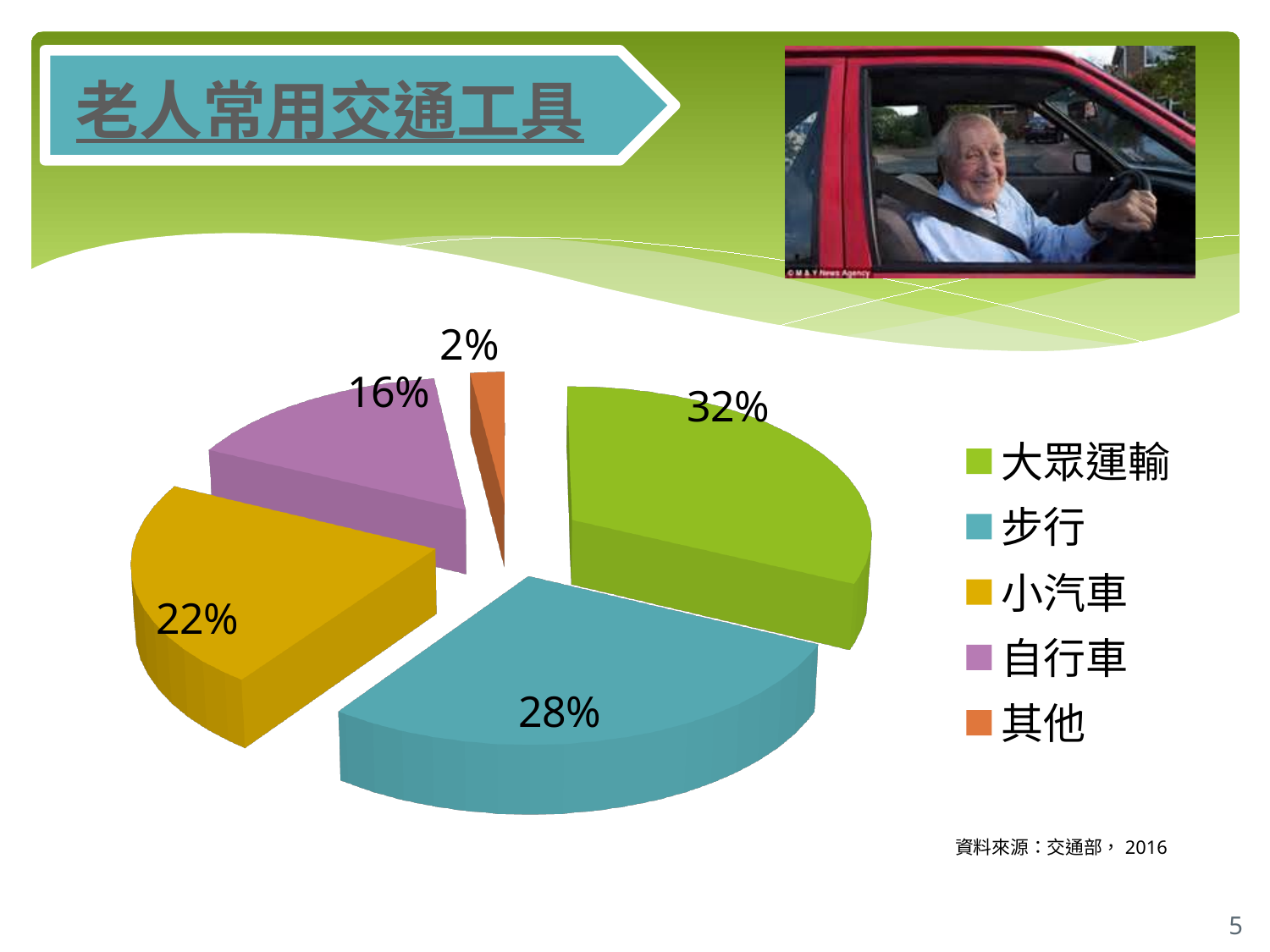
Which category has the largest share of the pie? 大眾運輸 What is the value for 步行? 28% What is the difference between the shares of 大眾運輸 and 步行? 4% What is the value for 其他? 2% How many categories does the pie chart show? 5 What is the value for 自行車? 16% What is the value for 小汽車? 22% Which colour represents 步行 in the legend? Blue Which is larger, the share for 小汽車 or the share for 自行車? 小汽車 What share of the pie does 大眾運輸 have? 32% Which category has the smallest share of the pie? 其他 What kind of chart is shown on the slide? Pie chart